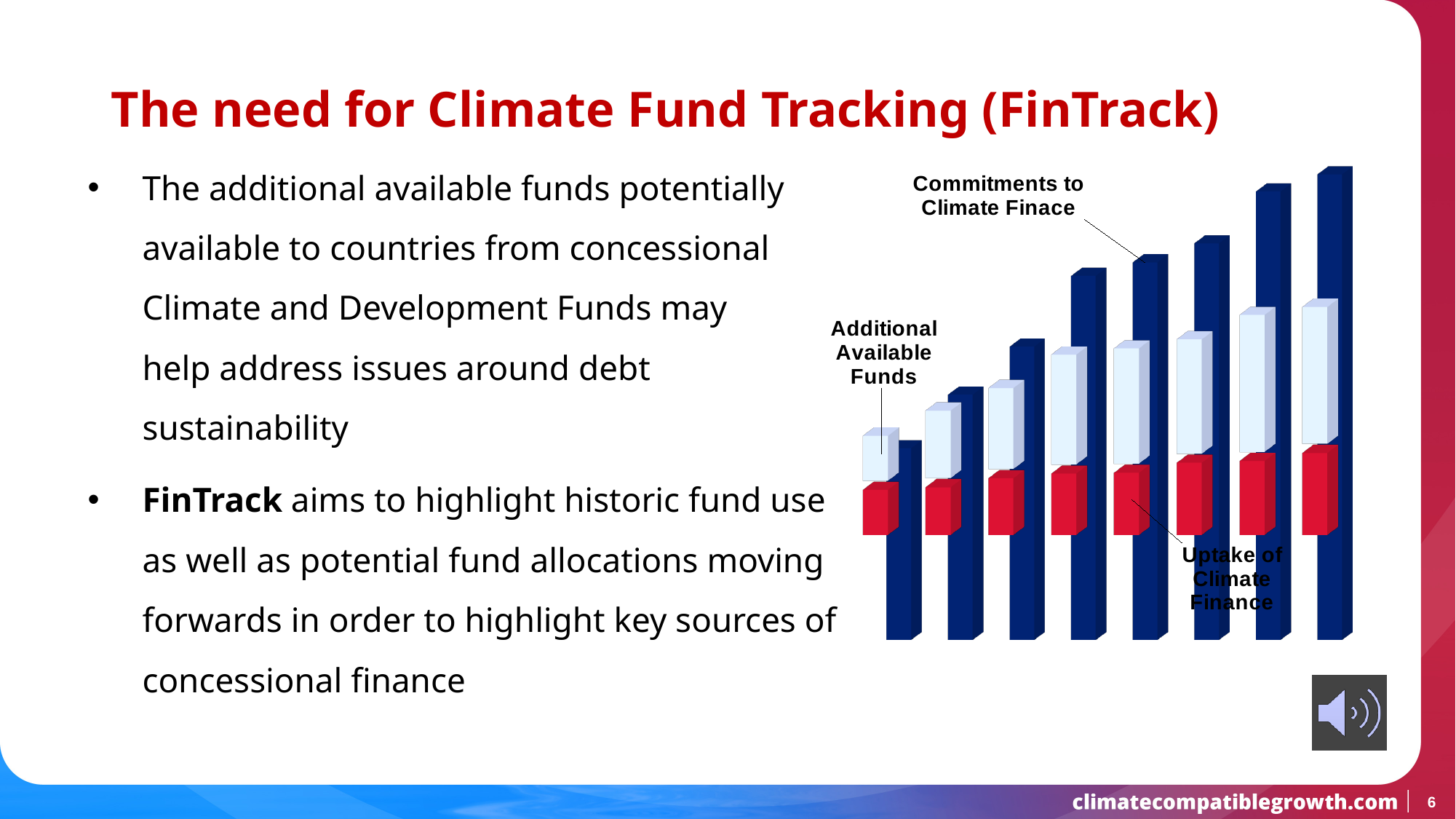
Which series has the shortest bars in the chart? Uptake of Climate Finance How many series are labelled in the chart? 3 Which series is drawn in dark blue in the chart? Commitments to Climate Finance In the chart, which series has the tallest bars: Commitments to Climate Finance or Uptake of Climate Finance? Commitments to Climate Finance What kind of chart is shown on the slide? bar chart Which series is drawn in red in the chart? Uptake of Climate Finance Do the Commitments to Climate Finance bars rise or fall from left to right? rise Which series has the tallest bars in the chart? Commitments to Climate Finance How many dark blue bars (Commitments to Climate Finance) are plotted in the chart? 8 Do the Additional Available Funds bars rise or fall from left to right? rise